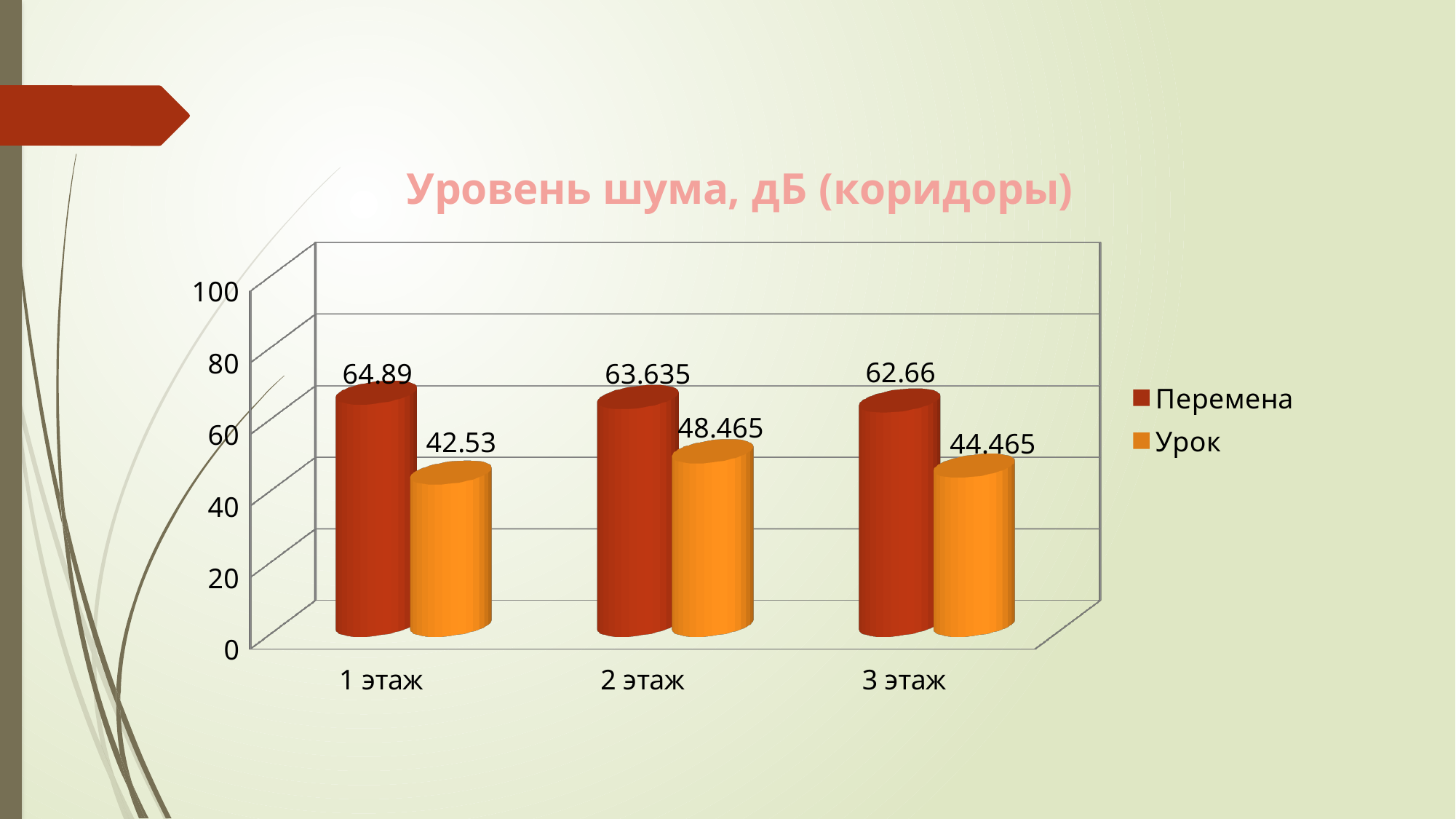
Do the values for Перемена rise or fall from 1 этаж to 3 этаж? fall How many categories are shown on the x axis? 3 What is the difference between Перемена and Урок on 1 этаж? 22.36 What type of chart is shown on the slide? bar chart What is the title of the chart? Уровень шума, дБ (коридоры) Which is larger on 3 этаж: Перемена or Урок? Перемена What is the value for Урок on 2 этаж? 48.465 Which floor has the highest value for Урок? 2 этаж Which floor has the lowest value for Перемена? 3 этаж How many series does the legend list? 2 What is the value for Перемена on 1 этаж? 64.89 What is the value for Урок on 3 этаж? 44.465